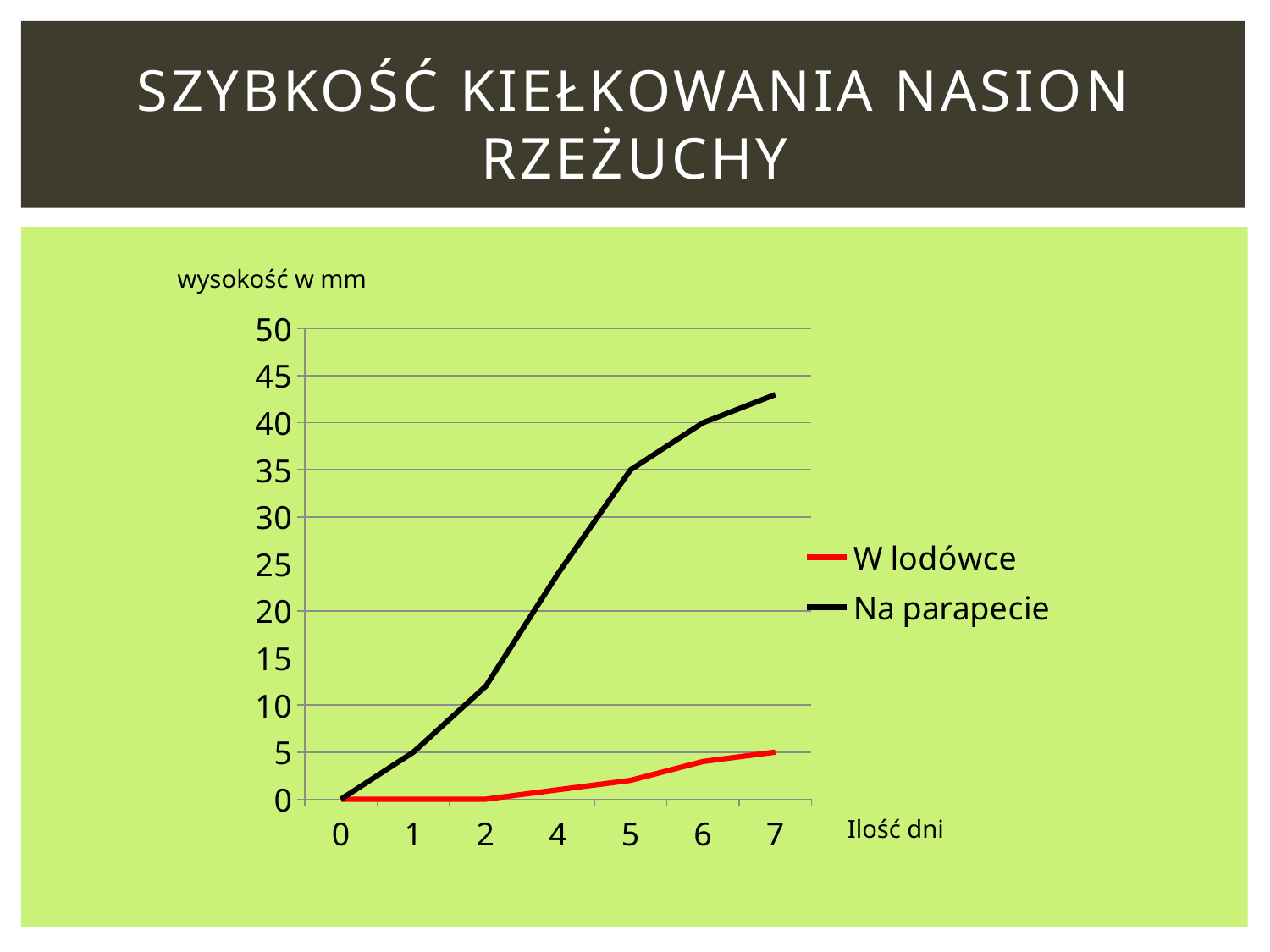
Do the values for Na parapecie rise or fall as the number of days increases? rise What is the value for Na parapecie at day 6? 40 What kind of chart is shown on the slide? line chart How many points along the x axis (Ilość dni) are plotted for each series? 7 Is the value for Na parapecie at day 7 greater or less than 40? greater What is the value for Na parapecie at day 5? 35 At day 4, which series has the larger value, W lodówce or Na parapecie? Na parapecie How many series does the legend list? 2 Is the value for Na parapecie at day 4 greater or less than 20? greater What is the value for W lodówce at day 2? 0 Which colour is used for the W lodówce series? red Is the value for W lodówce at day 6 greater or less than 5? less